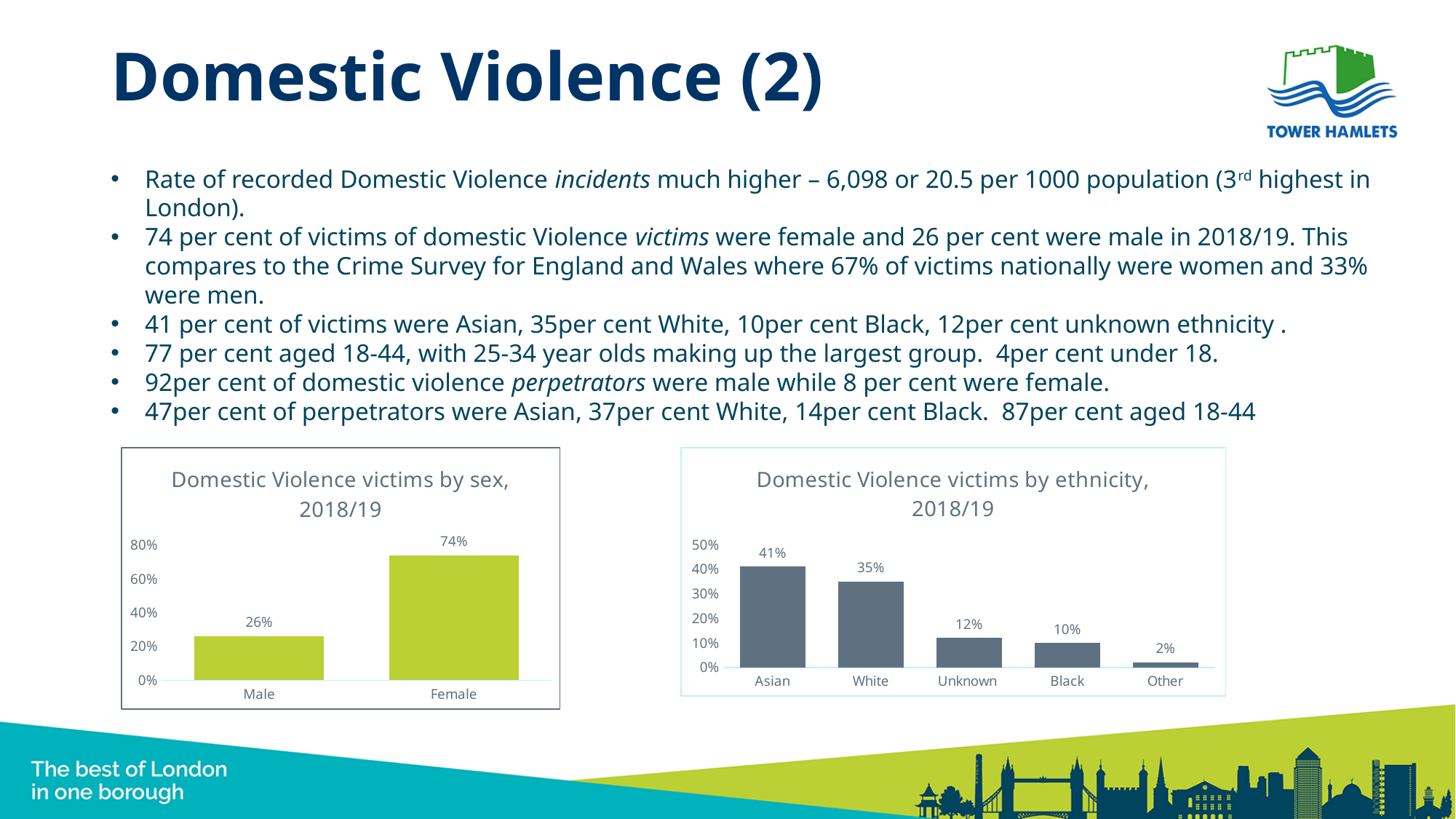
In the 'Domestic Violence victims by ethnicity, 2018/19' chart, which category has the highest value? Asian In the 'Domestic Violence victims by sex, 2018/19' chart, how many categories are shown? 2 In the 'Domestic Violence victims by ethnicity, 2018/19' chart, what is the value for Unknown? 12% In the 'Domestic Violence victims by ethnicity, 2018/19' chart, how many categories are shown on the x axis? 5 In the 'Domestic Violence victims by ethnicity, 2018/19' chart, what is the value for Asian? 41% In the 'Domestic Violence victims by sex, 2018/19' chart, what is the value for Female? 74% In the 'Domestic Violence victims by ethnicity, 2018/19' chart, which category has the lowest value? Other In the 'Domestic Violence victims by ethnicity, 2018/19' chart, which is larger, Unknown or Black? Unknown In the 'Domestic Violence victims by ethnicity, 2018/19' chart, what is the difference between the Asian and White values? 6% What kind of chart is 'Domestic Violence victims by sex, 2018/19'? Bar chart In the 'Domestic Violence victims by sex, 2018/19' chart, what is the difference between the Female and Male values? 48% In the 'Domestic Violence victims by sex, 2018/19' chart, what is the value for Male? 26%